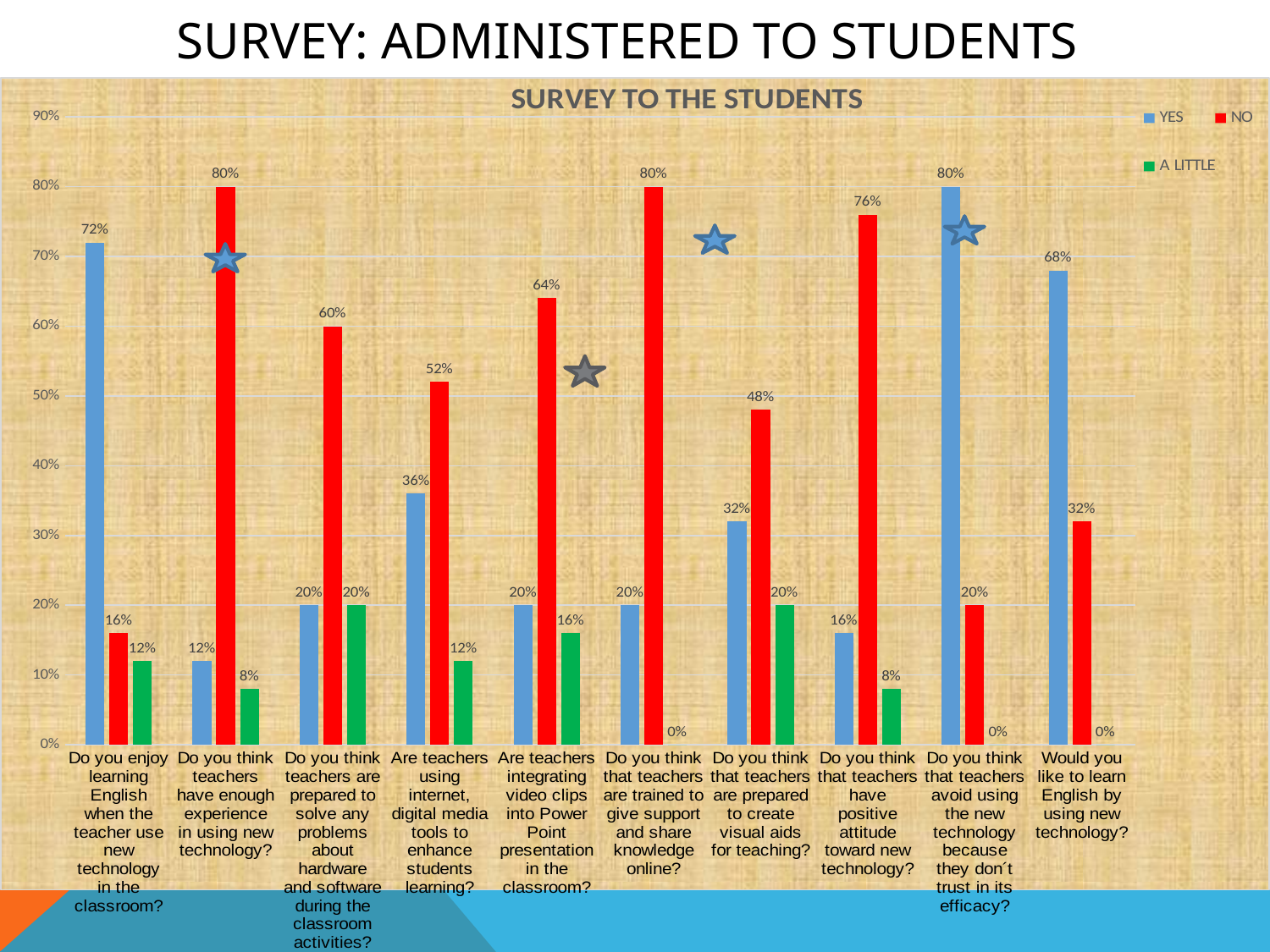
What is the difference between the NO and YES values for "Would you like to learn English by using new technology?" 36% For "Are teachers using internet, digital media tools to enhance students learning?", which is larger, the YES value or the NO value? NO What is the NO value for "Do you think that teachers have positive attitude toward new technology?" 76% What is the YES value for "Do you enjoy learning English when the teacher use new technology in the classroom?" 72% Which category has the highest YES value? Do you think that teachers avoid using the new technology because they don't trust in its efficacy? What is the NO value for "Do you think teachers have enough experience in using new technology?" 80% How many series does the legend list? 3 What colour represents the A LITTLE series? green What is the A LITTLE value for "Are teachers integrating video clips into Power Point presentation in the classroom?" 16% How many survey questions (categories) are plotted on the x axis? 10 What type of chart is shown on the slide? bar chart Which category has the lowest NO value? Do you enjoy learning English when the teacher use new technology in the classroom?